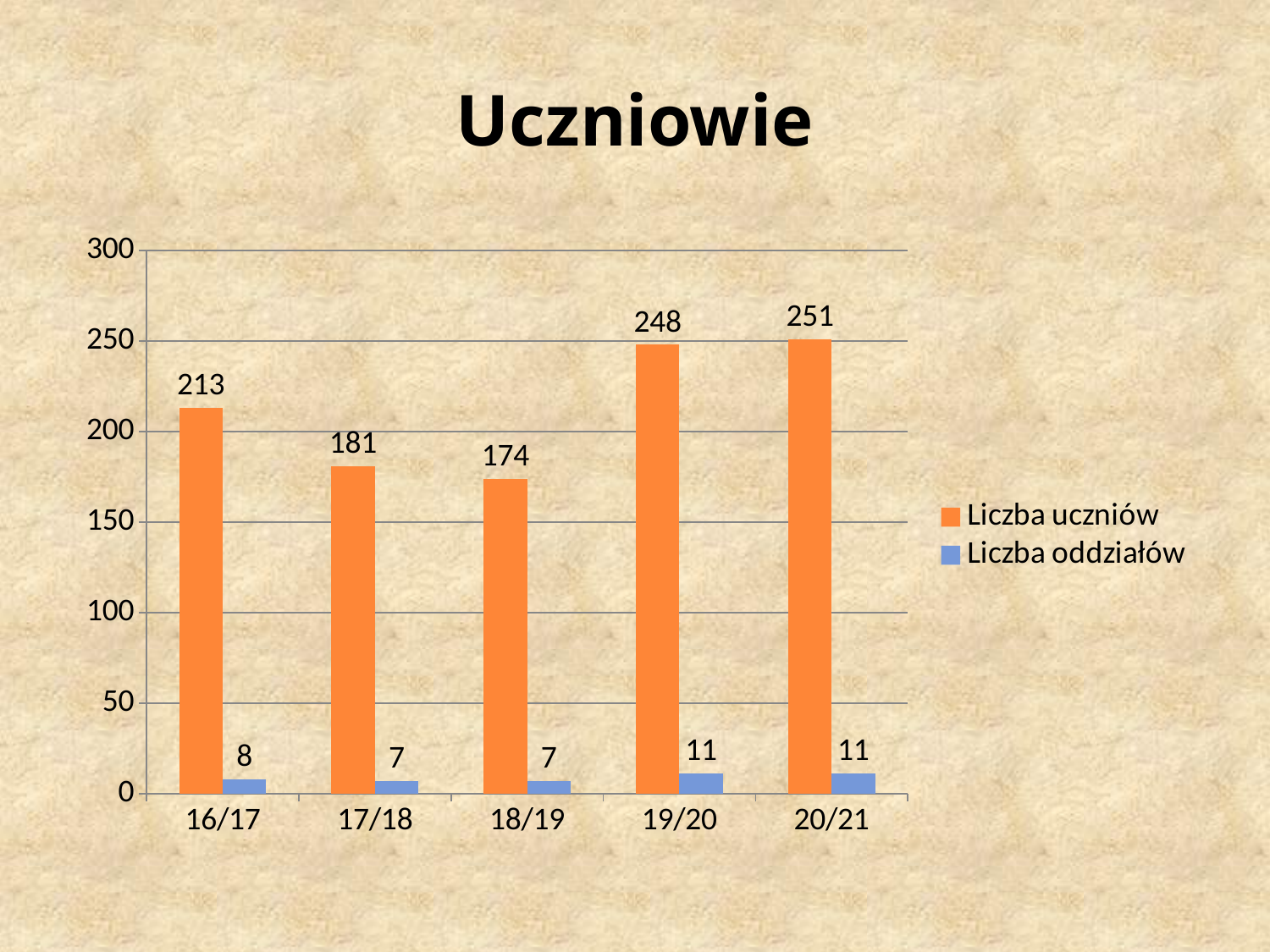
What is the value of Liczba uczniów for 18/19? 174 Which year has the lowest value for Liczba uczniów? 18/19 Which is larger, Liczba uczniów for 17/18 or for 18/19? 17/18 What is the value of Liczba uczniów for 16/17? 213 What is the value of Liczba oddziałów for 19/20? 11 What colour are the bars for Liczba oddziałów? blue What kind of chart is shown on the slide? bar chart What is the title of the chart? Uczniowie How many series does the legend list? 2 What is the difference between Liczba uczniów in 20/21 and 16/17? 38 Which year has the highest value for Liczba uczniów? 20/21 How many years are shown on the x axis? 5